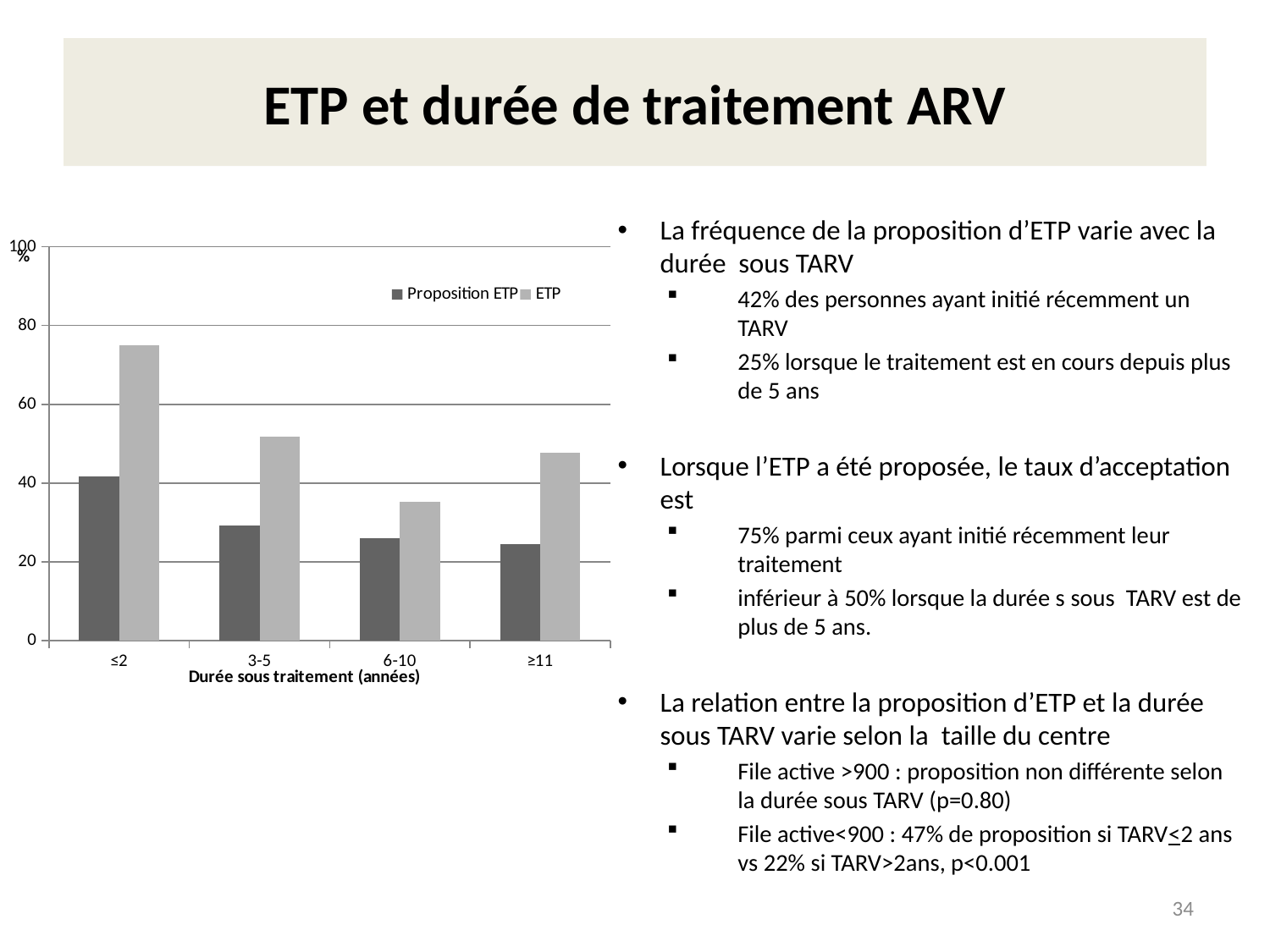
Is the ETP value for the 6-10 category greater or less than 40? less What kind of chart is shown on the slide? bar chart Is the ETP value for the ≤2 category greater or less than 60? greater Which duration category has the highest value for the Proposition ETP series? ≤2 How many series does the chart legend list? 2 Do the Proposition ETP values rise or fall as treatment duration increases along the x axis? fall Which duration category has the lowest value for the ETP series? 6-10 Is the Proposition ETP value for the ≥11 category greater or less than 40? less How many duration categories are shown on the x axis of the chart? 4 What is the title of the x axis of the chart? Durée sous traitement (années) Which duration category has the highest value for the ETP series? ≤2 For the ≤2 category, which is larger: Proposition ETP or ETP? ETP